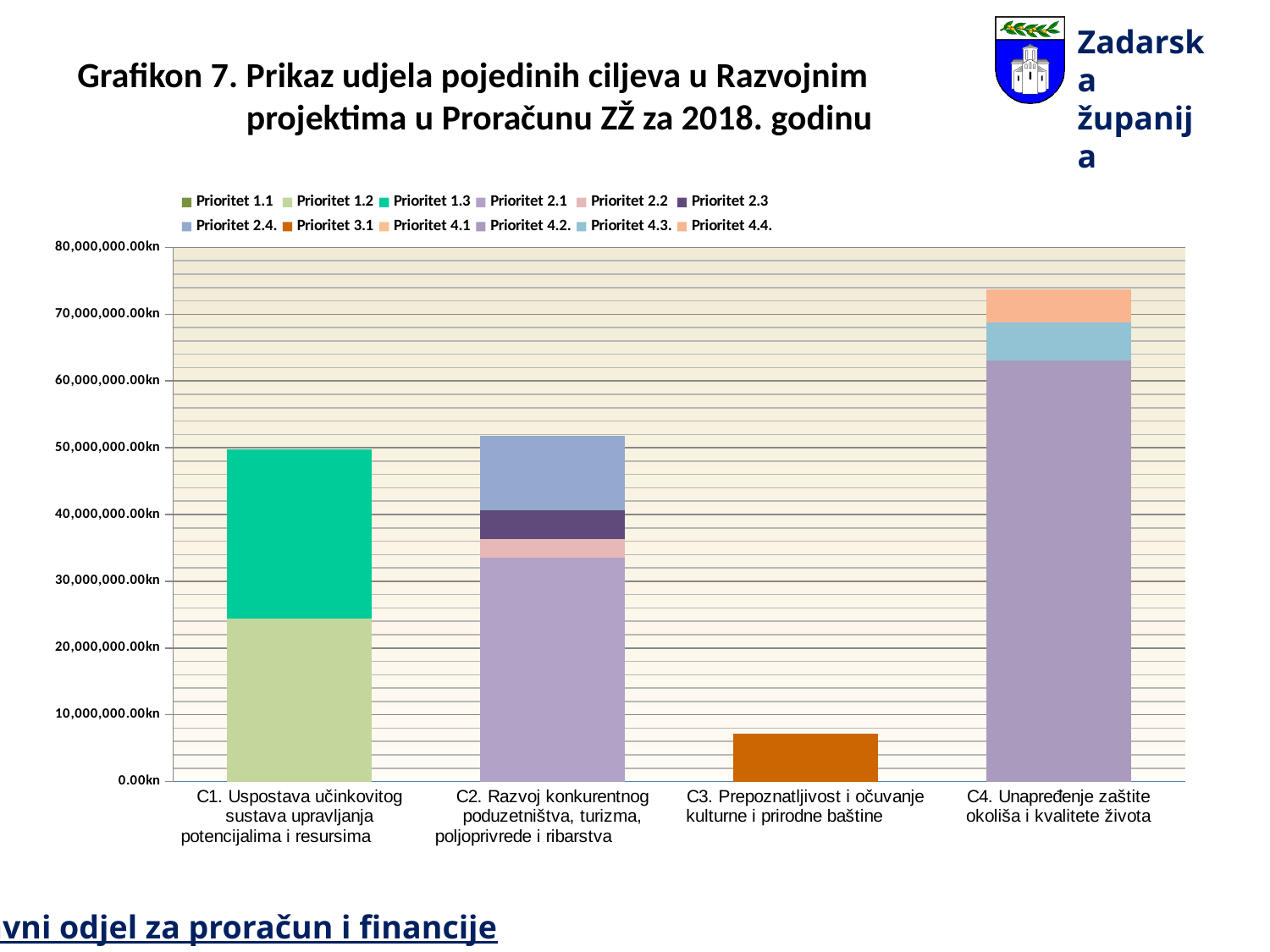
What kind of chart is shown on the slide? stacked bar chart Is the total value for C1. Uspostava učinkovitog sustava upravljanja potencijalima i resursima greater or less than 40,000,000.00kn? greater Is the total value for C2. Razvoj konkurentnog poduzetništva, turizma, poljoprivrede i ribarstva greater or less than 60,000,000.00kn? less How many categories (ciljevi) are shown on the x axis of the chart? 4 Which category's bar consists of only the Prioritet 3.1 series? C3. Prepoznatljivost i očuvanje kulturne i prirodne baštine Which has a larger total value: C4. Unapređenje zaštite okoliša i kvalitete života or C2. Razvoj konkurentnog poduzetništva, turizma, poljoprivrede i ribarstva? C4. Unapređenje zaštite okoliša i kvalitete života Is the total value for C4. Unapređenje zaštite okoliša i kvalitete života greater or less than 70,000,000.00kn? greater Which category has the tallest stacked bar? C4. Unapređenje zaštite okoliša i kvalitete života How many series does the chart legend list? 12 Which category has the shortest stacked bar? C3. Prepoznatljivost i očuvanje kulturne i prirodne baštine What is the title of the chart on the slide? Grafikon 7. Prikaz udjela pojedinih ciljeva u Razvojnim projektima u Proračunu ZŽ za 2018. godinu